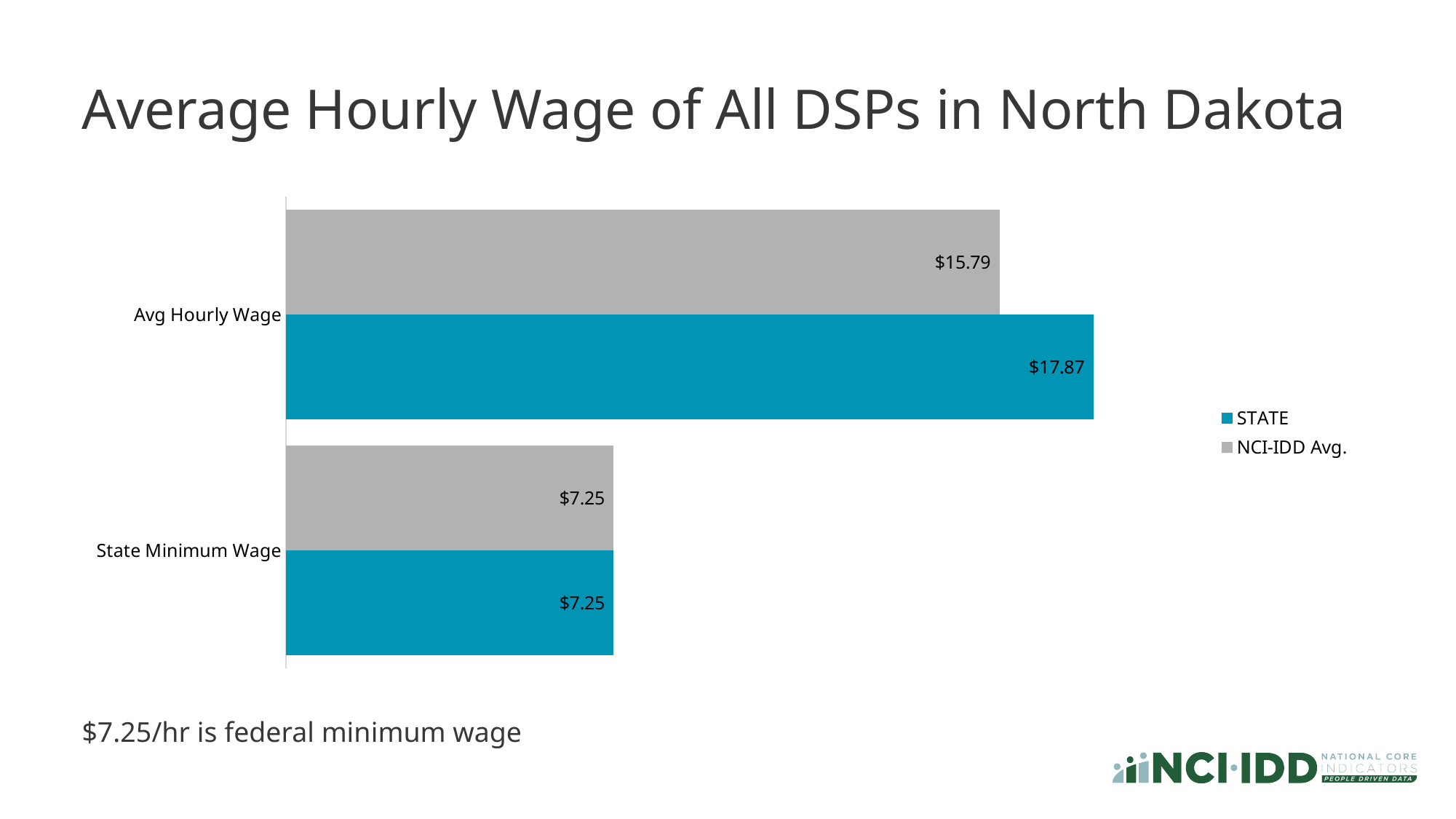
Which category has the highest STATE value? Avg Hourly Wage How many series does the legend list? 2 What is the STATE value for Avg Hourly Wage? $17.87 For Avg Hourly Wage, which is larger: the STATE value or the NCI-IDD Avg. value? STATE What is the NCI-IDD Avg. value for Avg Hourly Wage? $15.79 What is the difference between the STATE and NCI-IDD Avg. values for Avg Hourly Wage? $2.08 What is the NCI-IDD Avg. value for State Minimum Wage? $7.25 What kind of chart is shown on the slide? Bar chart What is the STATE value for State Minimum Wage? $7.25 What is the title of the chart? Average Hourly Wage of All DSPs in North Dakota How many categories are shown on the chart? 2 Which category has the lowest NCI-IDD Avg. value? State Minimum Wage